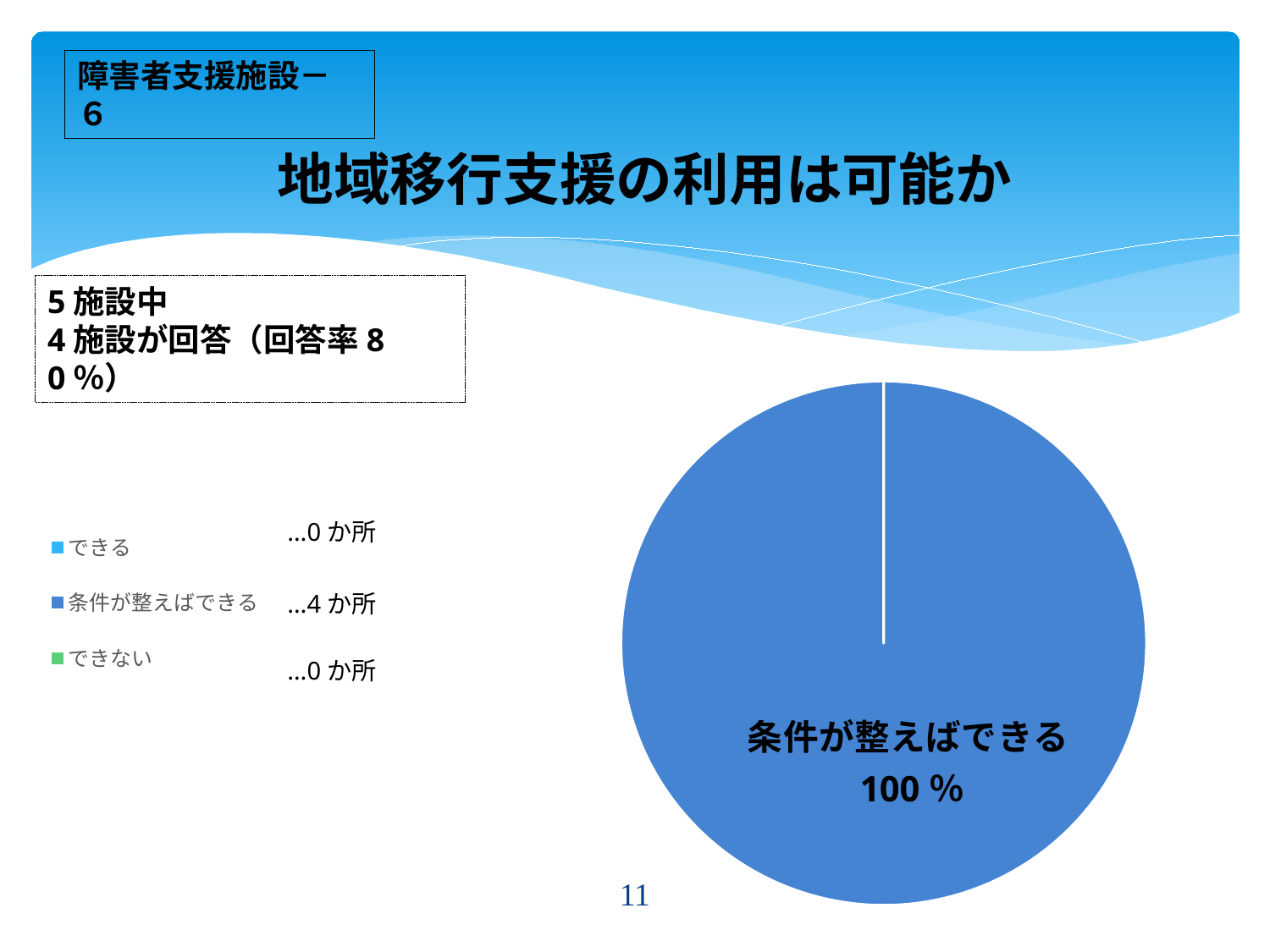
How many か所 are listed for 条件が整えばできる? 4 か所 How many entries does the legend list? 3 What is the difference between the values for 条件が整えばできる and できる? 4 か所 Which category has the highest value? 条件が整えばできる Which is larger, the value for 条件が整えばできる or the value for できない? 条件が整えばできる What share of the pie does 条件が整えばできる take? 100％ How many か所 are listed for できない? 0 か所 How many categories have a value of 0 か所? 2 What label is printed inside the pie slice? 条件が整えばできる 100％ How many か所 are listed for できる? 0 か所 What is the title of the slide containing the chart? 地域移行支援の利用は可能か What kind of chart is shown on the slide? pie chart